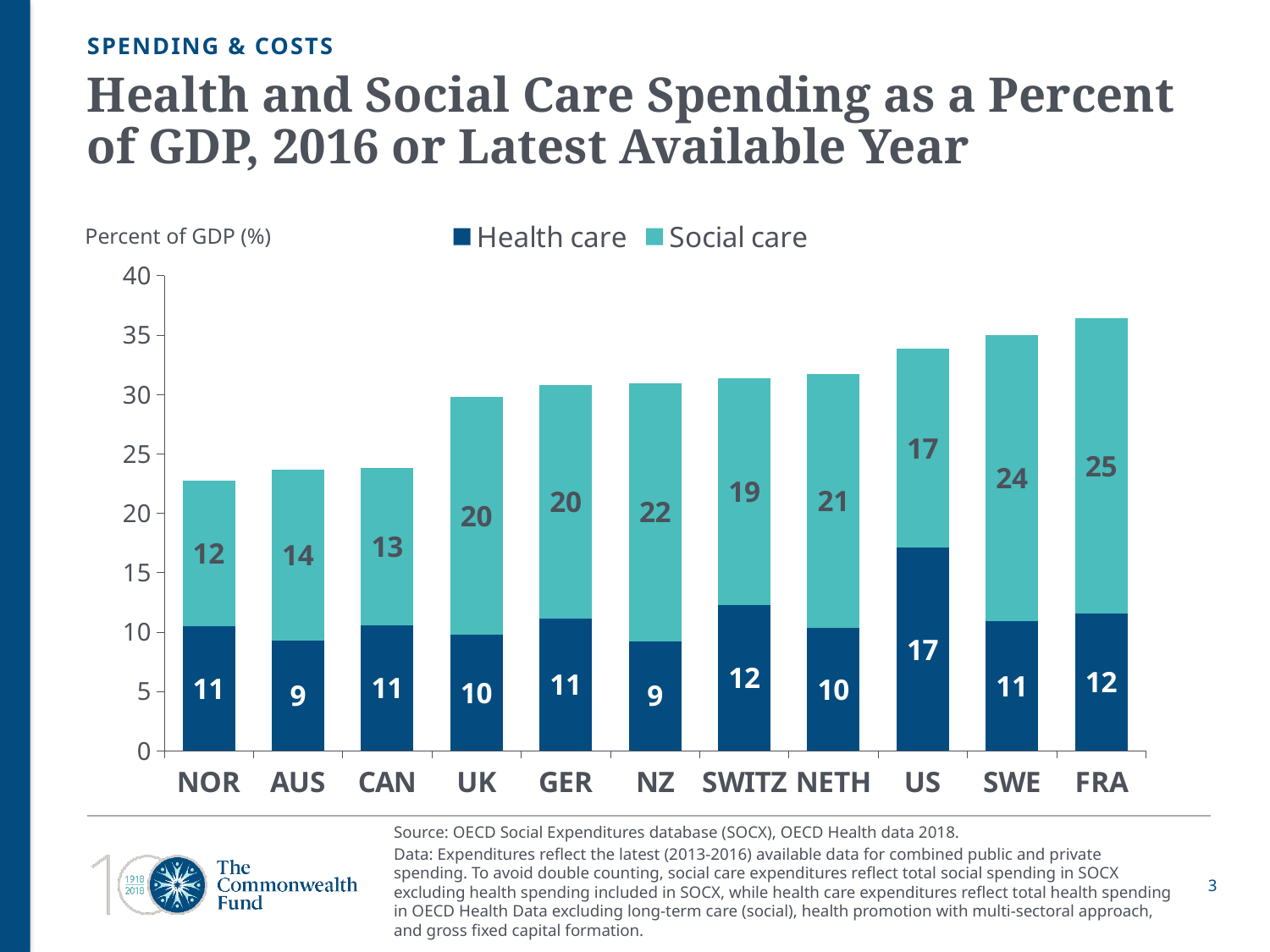
What is the social care spending as a percent of GDP for Sweden (SWE)? 24 Is the total height of the US bar greater or less than 30? greater How many countries are shown on the x axis? 11 What kind of chart is shown on the slide? Stacked bar chart How many series does the legend list? 2 Which country has the lowest social care spending as a percent of GDP? NOR Which has a larger social care value, SWE or SWITZ? SWE Which country has the highest social care spending as a percent of GDP? FRA What is the social care value shown for the UK? 20 What is the difference between the health care values for the US and the UK? 7 Which country has the highest health care spending as a percent of GDP? US What is the health care spending as a percent of GDP for the US? 17